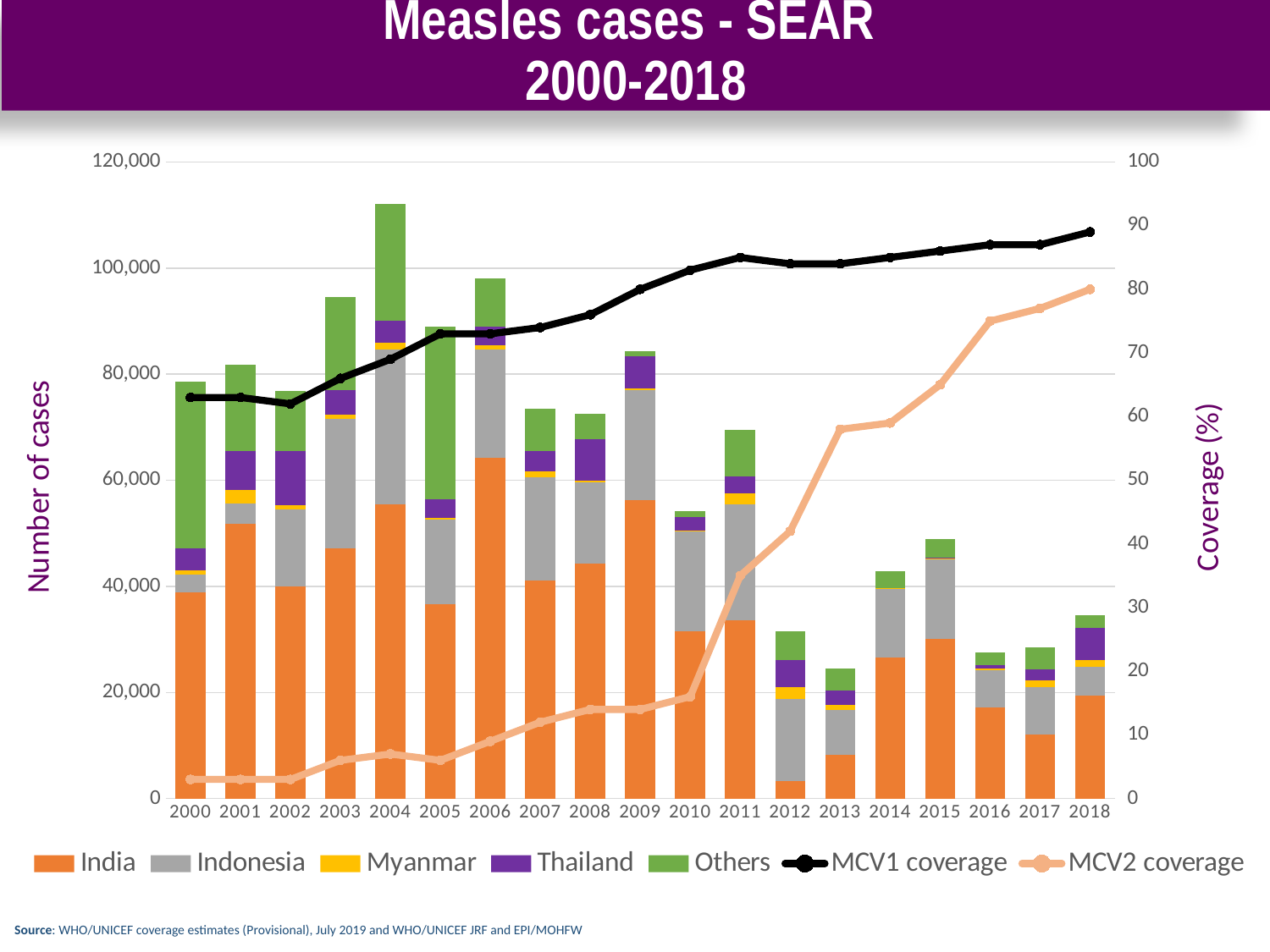
Which year has the highest total number of measles cases? 2004 Is the total number of cases in 2012 greater or less than 40,000? less Which colour represents India in the stacked bars? Orange Does MCV2 coverage generally rise or fall from 2000 to 2018? rise How many series does the legend list? 7 In 2010, which is higher: MCV1 coverage or MCV2 coverage? MCV1 coverage What kind of chart is shown on the slide? A stacked bar chart combined with line charts How many years are shown along the x axis? 19 Is the MCV2 coverage in 2000 greater or less than 10? less Is the MCV1 coverage in 2018 greater or less than 80? greater Which year has the lowest total number of measles cases? 2013